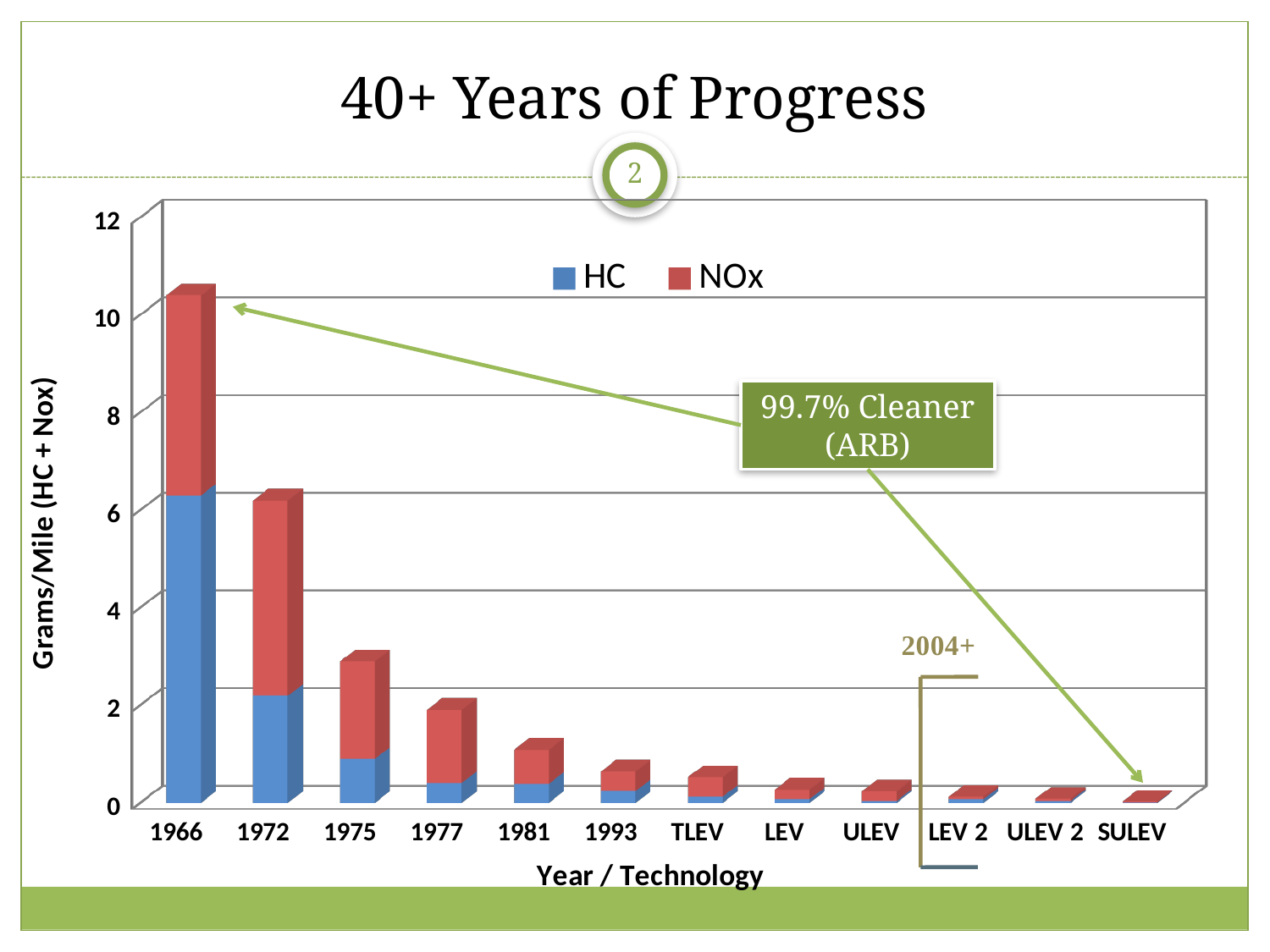
Is the total value for 1972 greater or less than 4? greater Which has the larger total, 1972 or 1975? 1972 Is the total value for 1981 greater or less than 2? less Is the total value for 1975 greater or less than 4? less How many categories are shown along the x axis? 12 Which category has the highest total emissions? 1966 What is the label on the y axis? Grams/Mile (HC + Nox) How many series does the legend list? 2 Which category has the lowest total emissions? SULEV Do the total emissions rise or fall moving from 1966 to SULEV along the x axis? fall What kind of chart is shown on the slide? Stacked bar chart